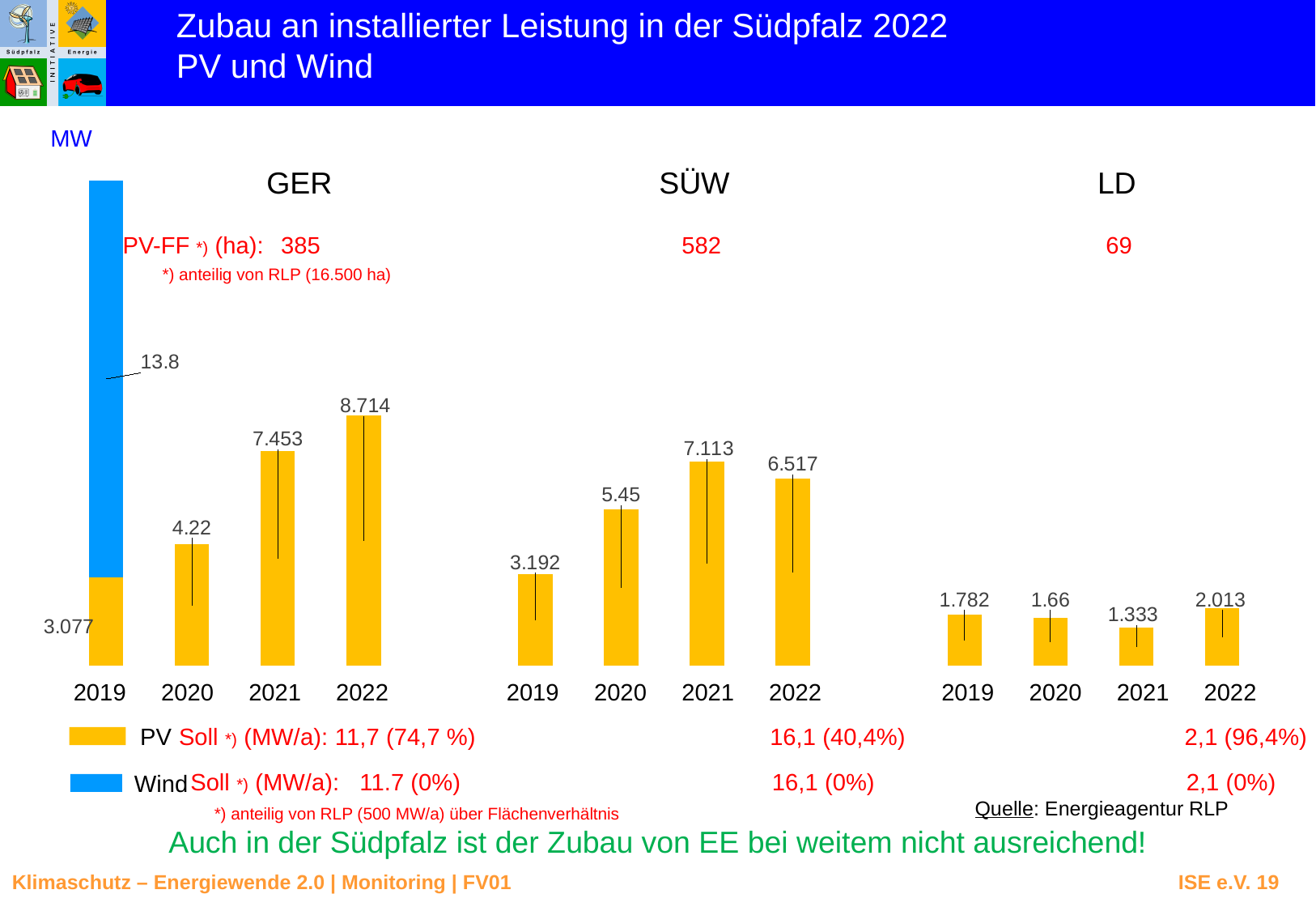
What is the PV value for LD in 2021? 1.333 Which is larger, the PV value for SÜW in 2021 or in 2022? 2021 What is the PV value for GER in 2022? 8.714 What is the difference between the PV values for GER in 2022 and 2021? 1.261 How many series does the legend list? 2 What is the Wind value for GER in 2019? 13.8 Which year has the lowest PV value in the LD group? 2021 Do the PV values for GER rise or fall from 2019 to 2022? rise What is the total of the stacked bar for GER in 2019 (PV plus Wind)? 16.877 What is the PV value for SÜW in 2020? 5.45 Which year has the highest PV value in the SÜW group? 2021 What kind of chart is shown on the slide? bar chart